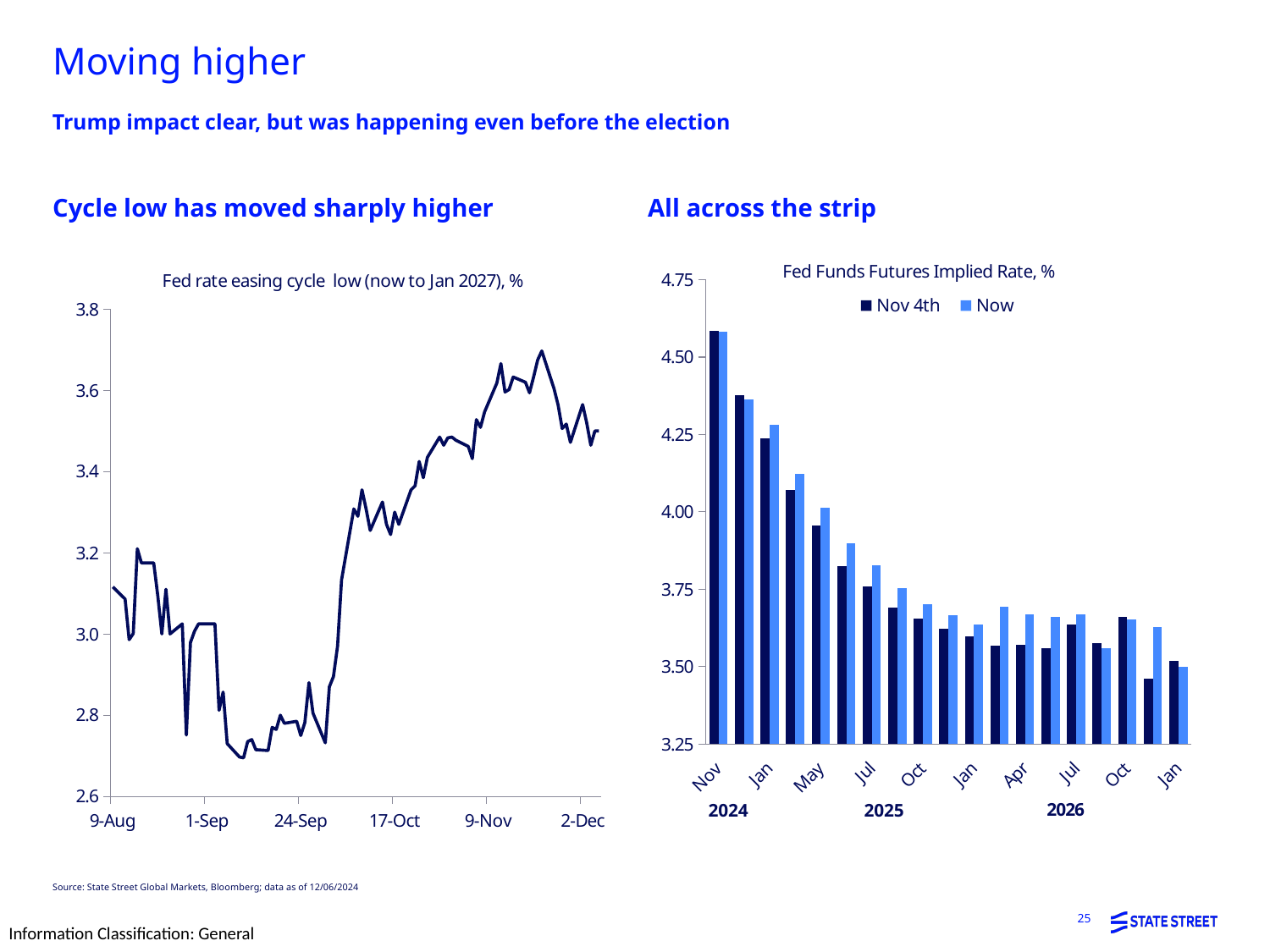
In the right chart, 'Fed Funds Futures Implied Rate, %', is the 'Now' value for Nov 2024 greater or less than 4.50? greater In the left chart, 'Fed rate easing cycle low (now to Jan 2027), %', is the lowest point of the line greater or less than 2.8? less How many series does the legend of the right chart, 'Fed Funds Futures Implied Rate, %', list? 2 In the left chart, 'Fed rate easing cycle low (now to Jan 2027), %', is the value at 9-Aug greater or less than 3.0? greater What kind of chart is the left chart, 'Fed rate easing cycle low (now to Jan 2027), %'? line chart What is the title of the left chart? Fed rate easing cycle low (now to Jan 2027), % In the right chart, 'Fed Funds Futures Implied Rate, %', which series is higher for May 2025, 'Nov 4th' or 'Now'? Now In the left chart, 'Fed rate easing cycle low (now to Jan 2027), %', is the line higher at 2-Dec or at 9-Aug? 2-Dec In the right chart, 'Fed Funds Futures Implied Rate, %', do the bars generally rise or fall from left to right along the x axis? fall What kind of chart is the right chart, 'Fed Funds Futures Implied Rate, %'? bar chart What are the two series named in the legend of the right chart, 'Fed Funds Futures Implied Rate, %'? Nov 4th and Now